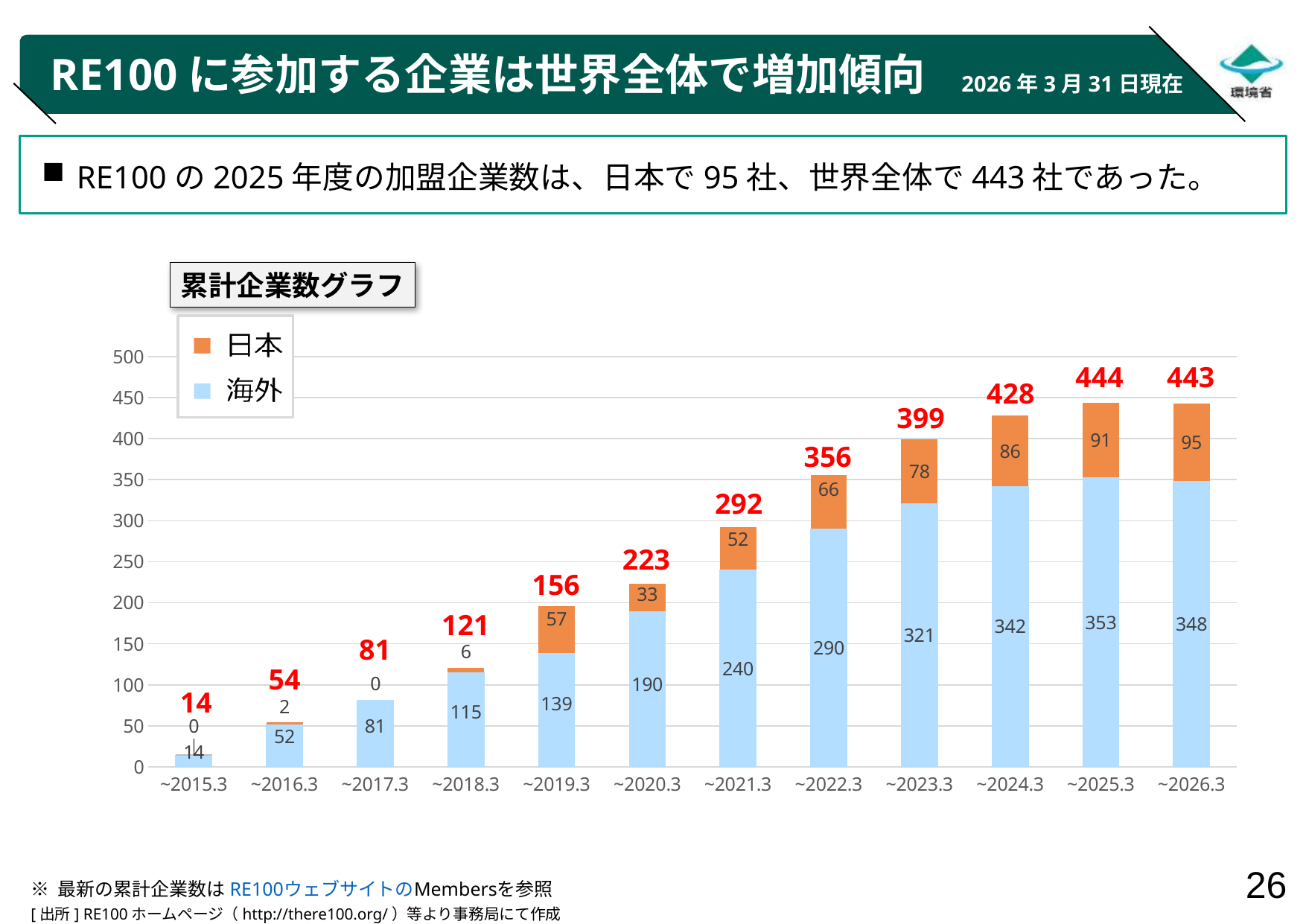
What is the 日本 value for ~2024.3? 86 Which period has the lowest total? ~2015.3 What is the difference between the 日本 values for ~2026.3 and ~2025.3? 4 What is the 海外 value for ~2026.3? 348 Which is larger, the 海外 value for ~2021.3 or for ~2020.3? ~2021.3 What is the title shown above the chart? 累計企業数グラフ Do the totals generally rise or fall from ~2015.3 to ~2025.3? rise Which period has the highest total? ~2025.3 What type of chart is shown on the slide? stacked bar chart What is the total of the stacked bar for ~2022.3? 356 How many series does the legend list? 2 How many categories (periods) are shown on the x axis? 12